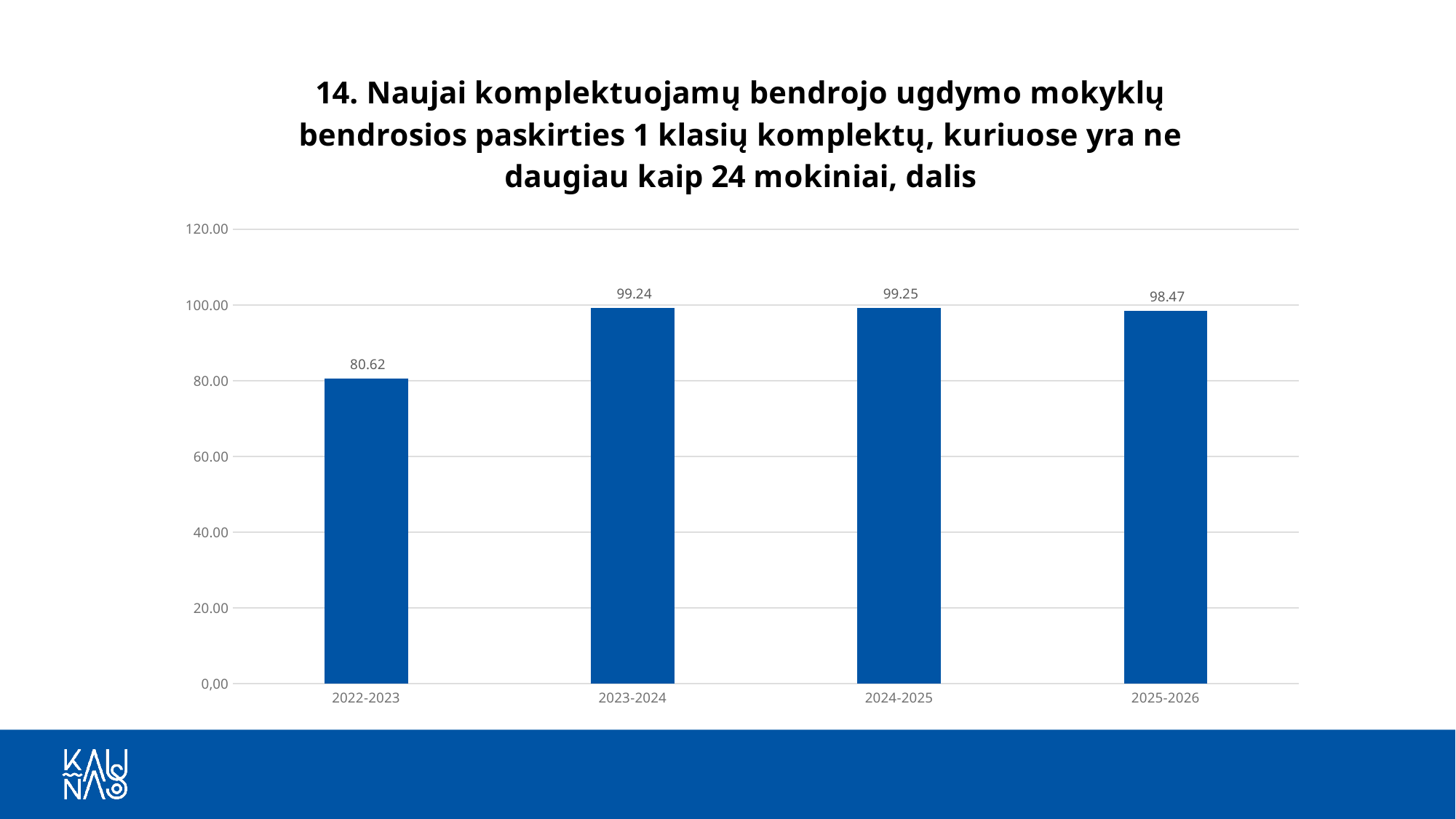
Which is larger, the value for 2022-2023 or the value for 2025-2026? 2025-2026 What is the difference between the values for 2025-2026 and 2022-2023? 17.85 What kind of chart is shown on the slide? bar chart What is the value for 2022-2023? 80.62 What is the value for 2025-2026? 98.47 What is the value for 2023-2024? 99.24 Is the value for 2022-2023 greater or less than 100.00? less What is the difference between the values for 2023-2024 and 2022-2023? 18.62 What is the value for 2024-2025? 99.25 Which school year has the highest value? 2024-2025 Which school year has the lowest value? 2022-2023 How many school years are shown on the x axis? 4